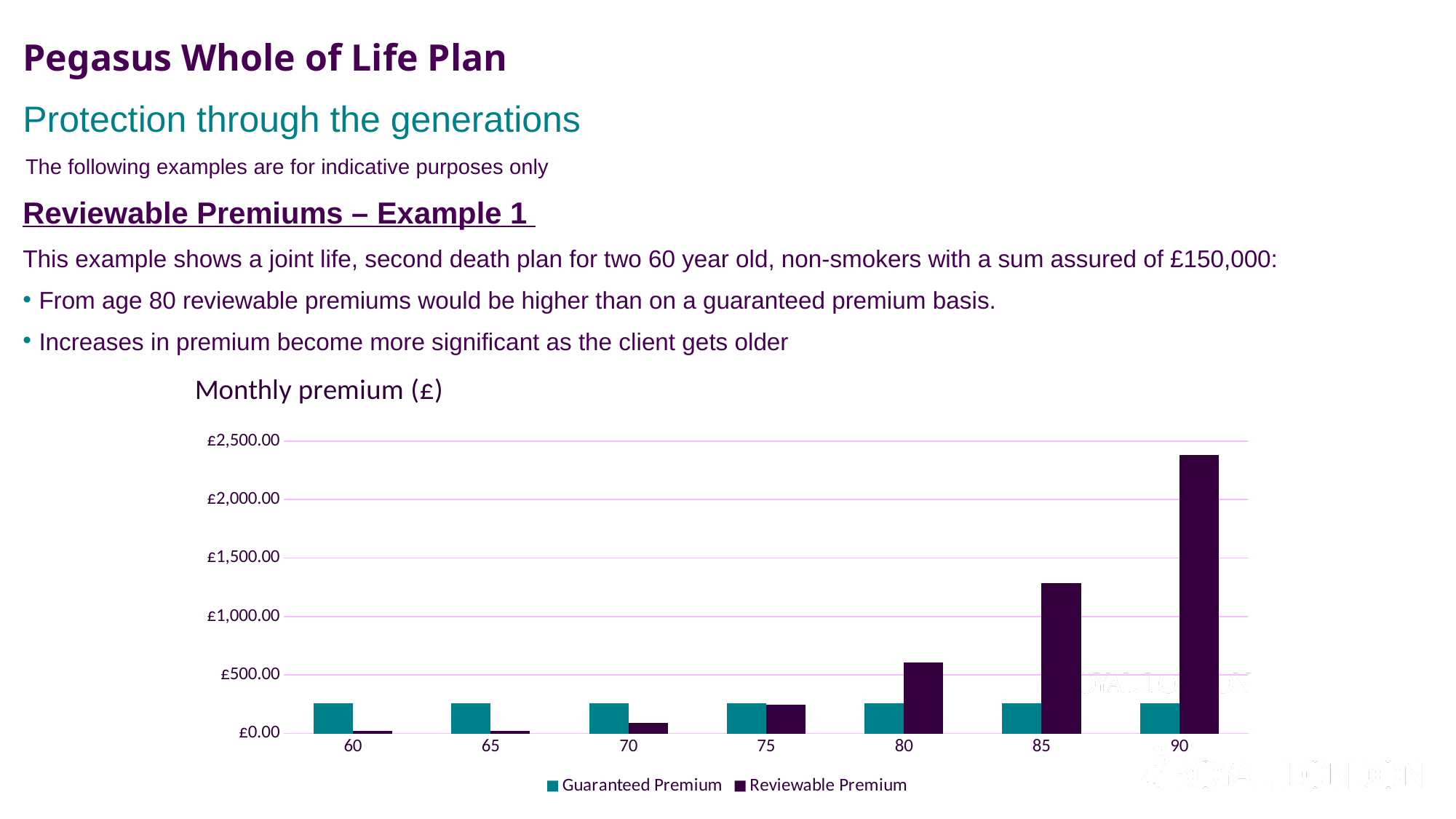
What is the title of the chart? Monthly premium (£) Is the Guaranteed Premium at age 60 greater or less than £500.00? less Does the Reviewable Premium rise or fall as age increases from 60 to 90? rise How many series does the chart legend list? 2 How many age categories are shown on the x axis of the chart? 7 What kind of chart is shown on the slide? bar chart Is the Reviewable Premium at age 90 greater or less than £2,000.00? greater Is the Reviewable Premium at age 80 greater or less than £1,000.00? less Which series is shown in teal in the chart? Guaranteed Premium At age 85, which is larger: the Guaranteed Premium or the Reviewable Premium? Reviewable Premium At which age is the Reviewable Premium highest? 90